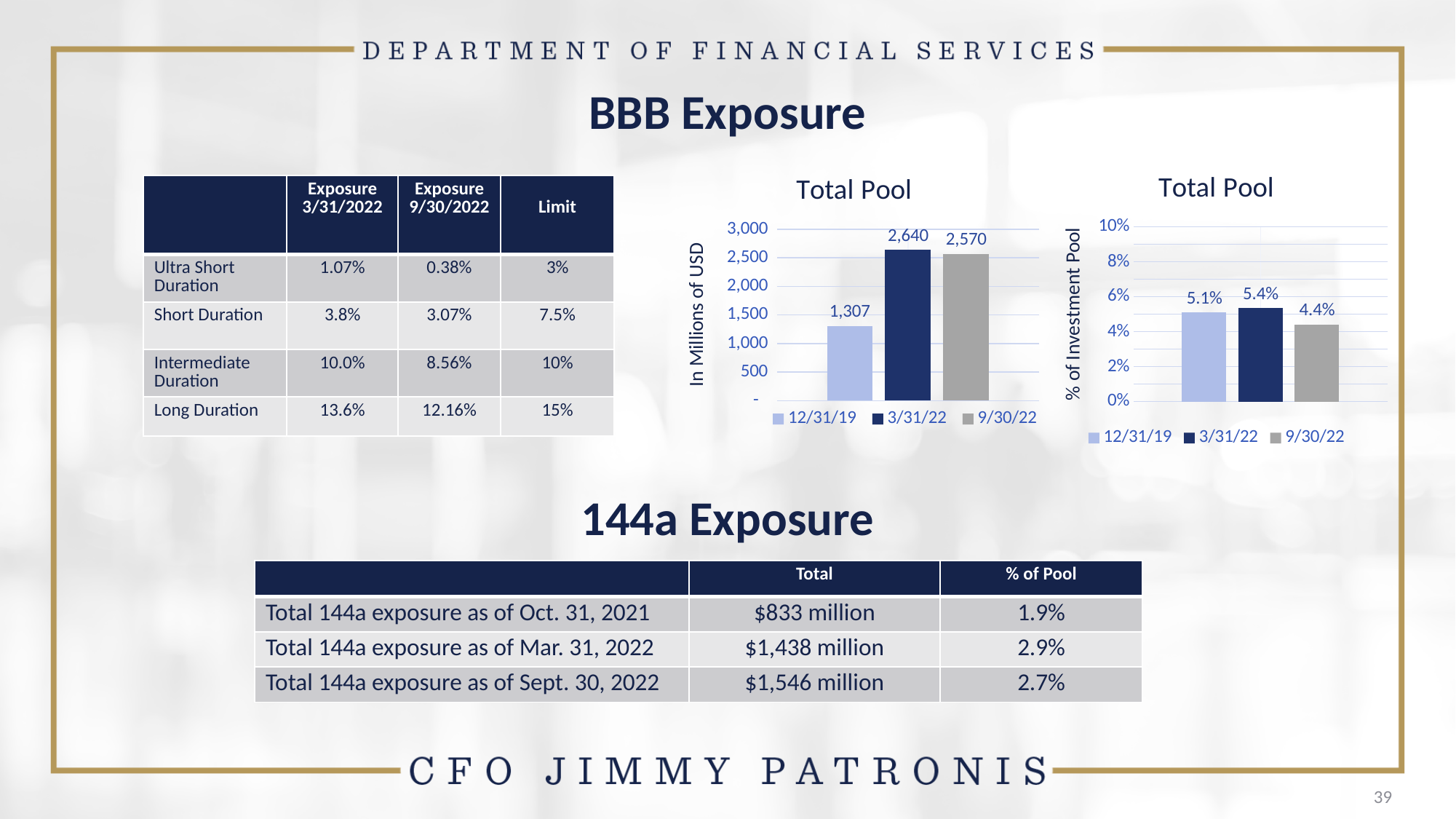
In the left 'Total Pool' chart (In Millions of USD), which date has the lowest value? 12/31/19 In the left 'Total Pool' chart (In Millions of USD), what is the value for 12/31/19? 1,307 What is the y-axis label of the left 'Total Pool' chart? In Millions of USD In the left 'Total Pool' chart (In Millions of USD), which date has the highest value? 3/31/22 In the left 'Total Pool' chart (In Millions of USD), what is the difference between the 3/31/22 and 9/30/22 values? 70 In the right 'Total Pool' chart (% of Investment Pool), what is the value for 9/30/22? 4.4% What kind of chart is the right 'Total Pool' chart (% of Investment Pool)? bar chart In the right 'Total Pool' chart (% of Investment Pool), is the value for 12/31/19 larger or smaller than the value for 9/30/22? larger In the left 'Total Pool' chart (In Millions of USD), what is the value for 3/31/22? 2,640 How many series does the legend of the left 'Total Pool' chart (In Millions of USD) list? 3 In the right 'Total Pool' chart (% of Investment Pool), what is the value for 12/31/19? 5.1% In the right 'Total Pool' chart (% of Investment Pool), which date has the highest value? 3/31/22